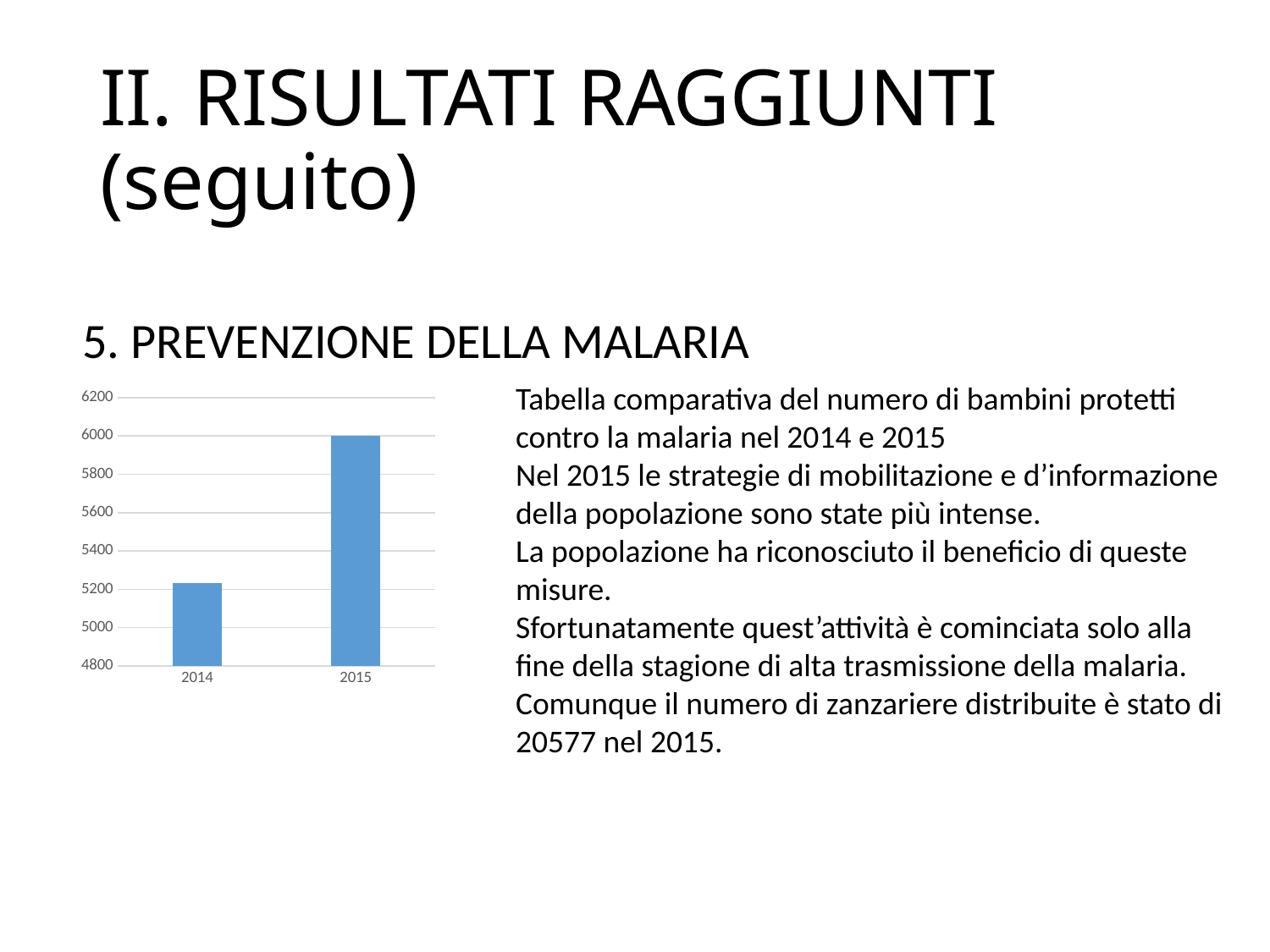
What value does the bar for 2015 reach on the vertical axis? 6000 How many bars are plotted in the chart? 2 Which year has the highest bar in the chart? 2015 What is the highest value shown on the vertical axis of the chart? 6200 What is the lowest value shown on the vertical axis of the chart? 4800 Which year has the lowest bar in the chart? 2014 Which is larger, the value for 2014 or the value for 2015? 2015 Is the value for 2014 greater or less than 5400? less Is the value for 2015 greater or less than 5800? greater Do the values rise or fall from 2014 to 2015? rise Is the value for 2014 greater or less than 5000? greater What kind of chart is shown on the slide? bar chart